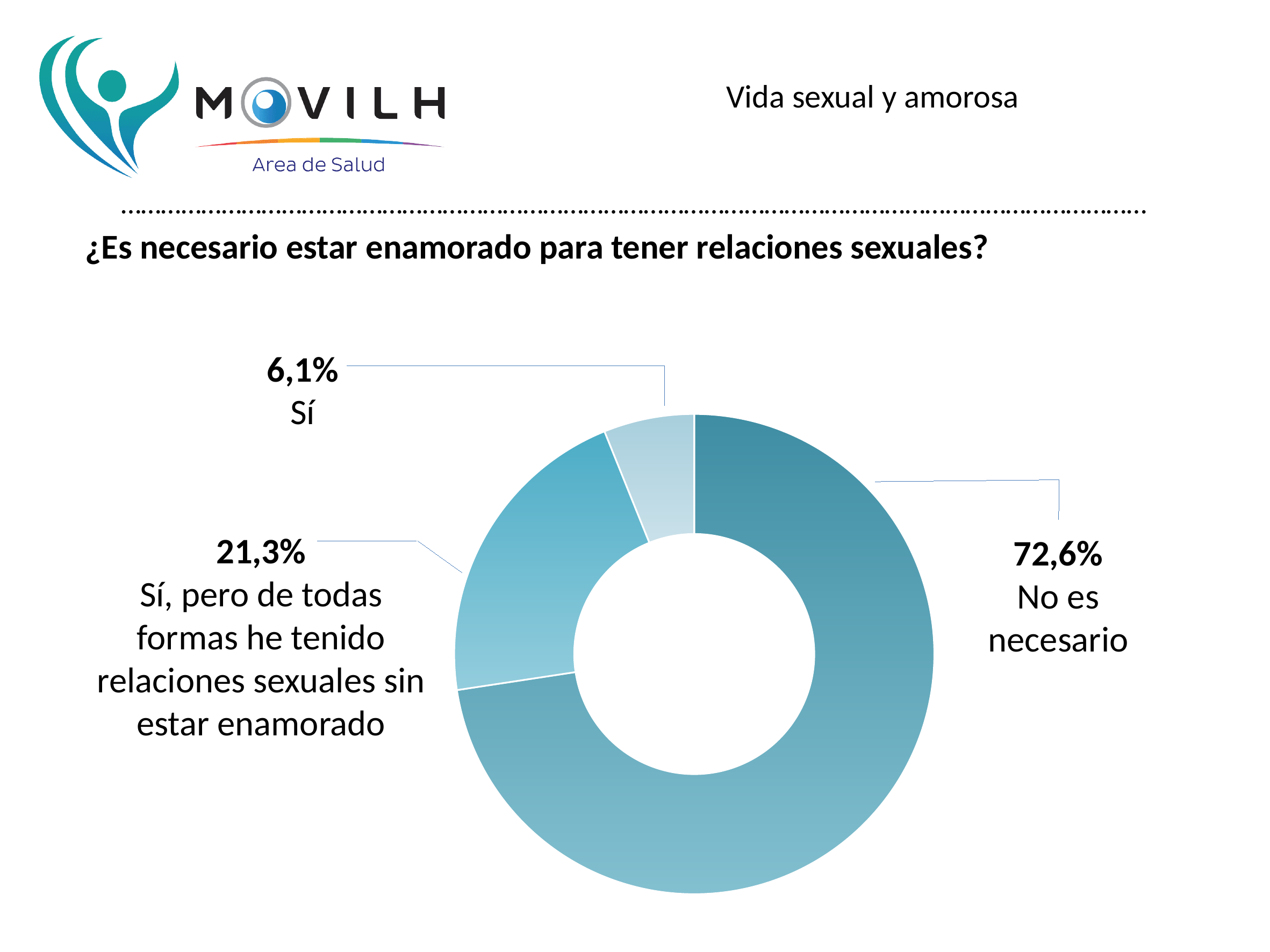
What is the difference in percentage points between "Sí, pero de todas formas he tenido relaciones sexuales sin estar enamorado" and "Sí"? 15,2 What percentage of respondents answered "Sí"? 6,1% Which response has the largest share of the chart? No es necesario Which is larger: the share for "Sí" or the share for "Sí, pero de todas formas he tenido relaciones sexuales sin estar enamorado"? Sí, pero de todas formas he tenido relaciones sexuales sin estar enamorado Which response has the smallest share of the chart? Sí What percentage of respondents answered "No es necesario"? 72,6% What is the section title shown at the top right of the slide? Vida sexual y amorosa What is the difference in percentage points between "No es necesario" and "Sí, pero de todas formas he tenido relaciones sexuales sin estar enamorado"? 51,3 What percentage of respondents answered "Sí, pero de todas formas he tenido relaciones sexuales sin estar enamorado"? 21,3% How many response categories are shown in the chart? 3 What kind of chart is shown on the slide? Doughnut chart What question does the chart on the slide answer? ¿Es necesario estar enamorado para tener relaciones sexuales?